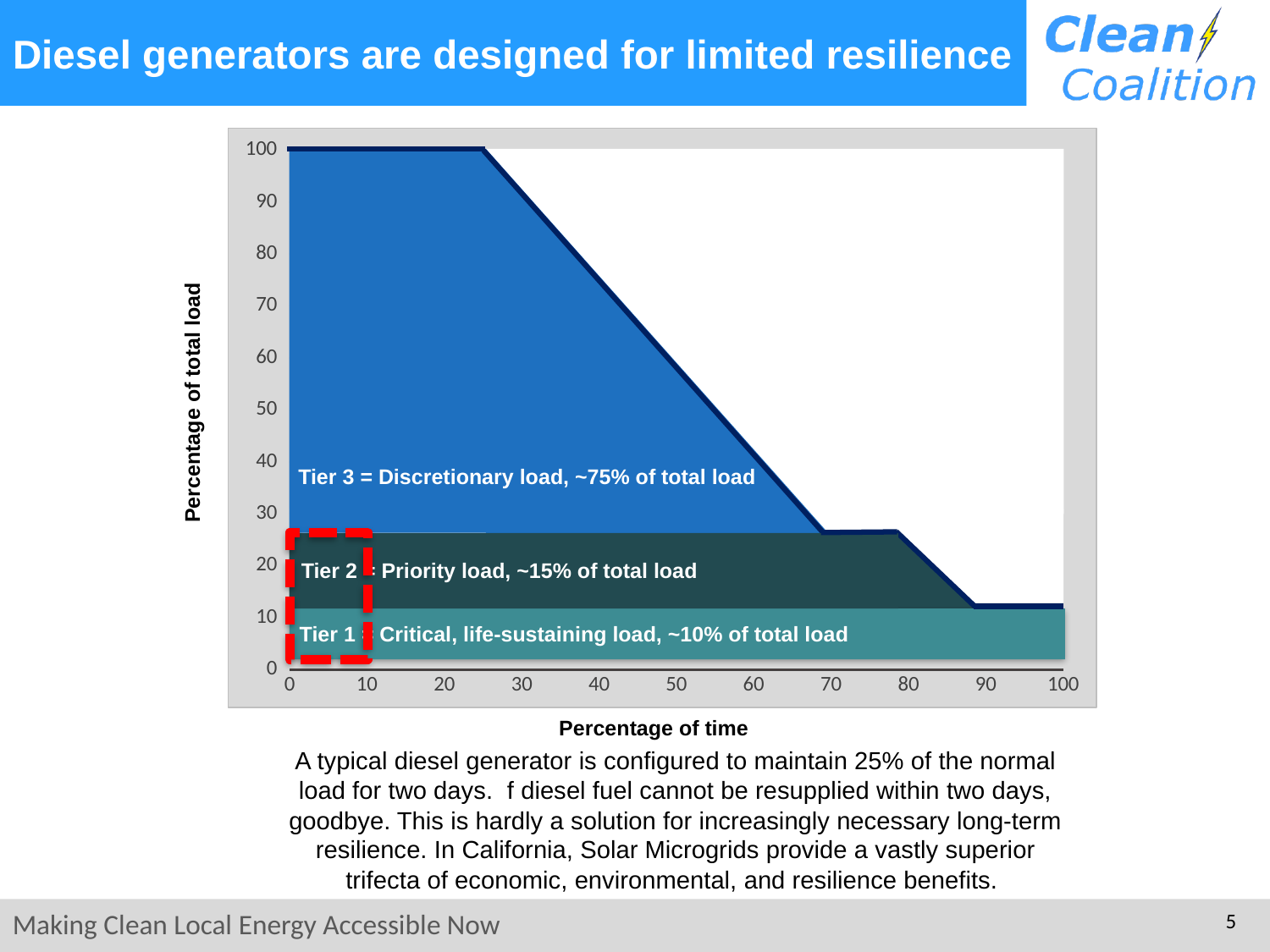
What is the title of the chart's x axis? Percentage of time Is the percentage of total load at 95% of time greater or less than 20? less Is the percentage of total load at 50% of time greater or less than 40? greater How many load tiers are labelled on the chart? 3 Is the percentage of total load at 40% of time greater or less than 60? greater According to the chart label, what share of total load is Tier 1, the critical, life-sustaining load? ~10% of total load What is the percentage of total load at 10% of time? 100 What kind of chart is shown on the slide? Area chart Overall, does the percentage of total load rise or fall as the percentage of time increases? Fall What is the title of the chart's y axis? Percentage of total load What is the percentage of total load at 0% of time? 100